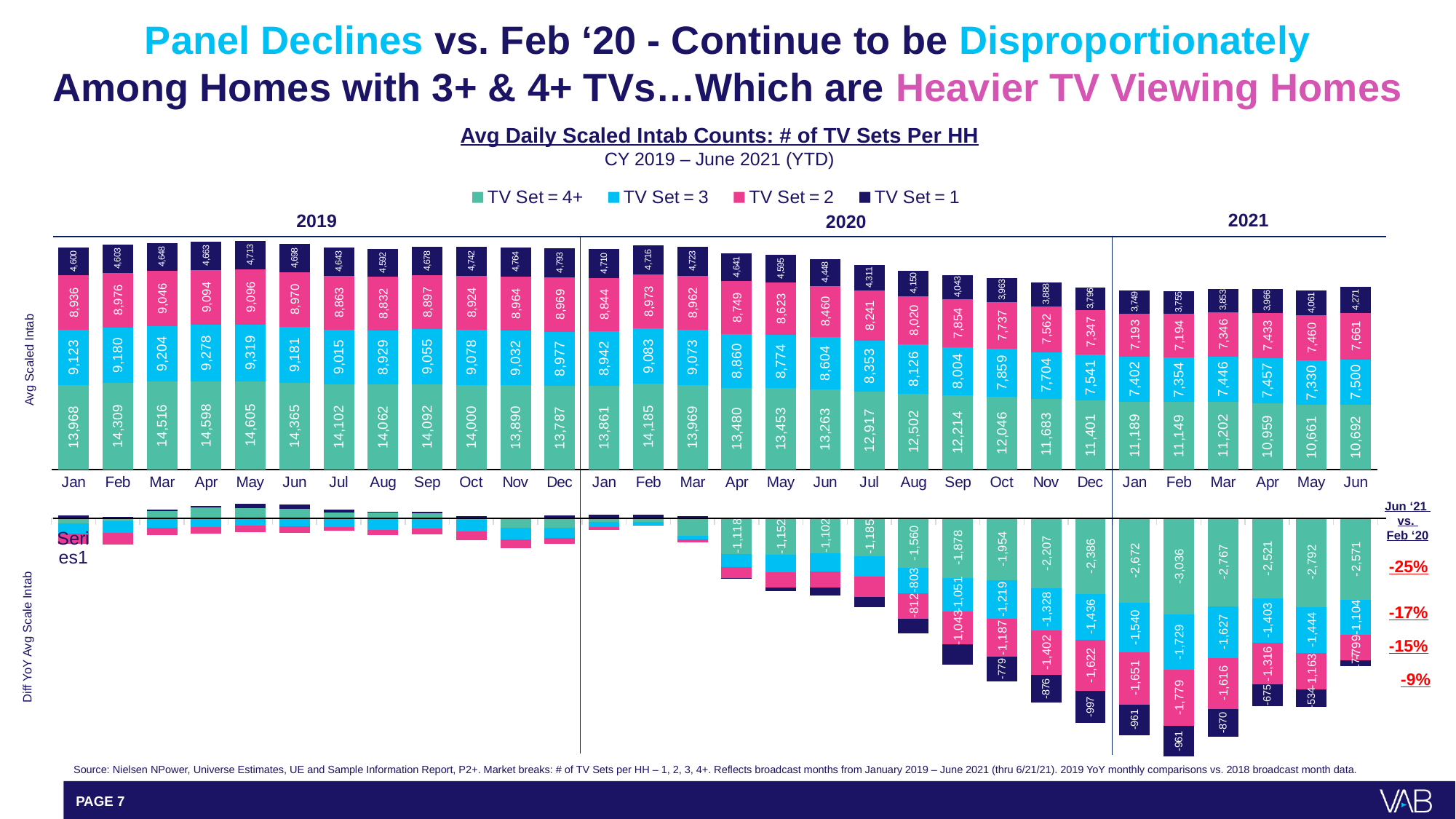
In the top chart (Avg Daily Scaled Intab Counts), which month has the lowest value for TV Set = 4+? May 2021 In the top chart (Avg Daily Scaled Intab Counts), what is the value for TV Set = 3 in Feb 2020? 9,083 What kind of chart is the top chart (Avg Daily Scaled Intab Counts)? Stacked bar chart In the top chart (Avg Daily Scaled Intab Counts), what is the difference between the TV Set = 4+ value in Feb 2020 and in Jun 2021? 3,493 In the bottom chart (Diff YoY Avg Scale Intab), what is the value for TV Set = 4+ in Feb 2021? -3,036 In the top chart (Avg Daily Scaled Intab Counts), what is the value for TV Set = 1 in Jun 2021? 4,271 In the top chart (Avg Daily Scaled Intab Counts), which month has the highest value for TV Set = 4+? May 2019 In the top chart (Avg Daily Scaled Intab Counts), what is the total of the stacked bar for Jan 2019? 36,627 How many series does the legend of the top chart list? 4 In the top chart (Avg Daily Scaled Intab Counts), which is larger in Jun 2021: TV Set = 3 or TV Set = 2? TV Set = 2 In the top chart (Avg Daily Scaled Intab Counts), does the TV Set = 4+ value rise or fall from Jan 2020 to Dec 2020? Fall In the top chart (Avg Daily Scaled Intab Counts), what is the value for TV Set = 4+ in Jan 2019? 13,968